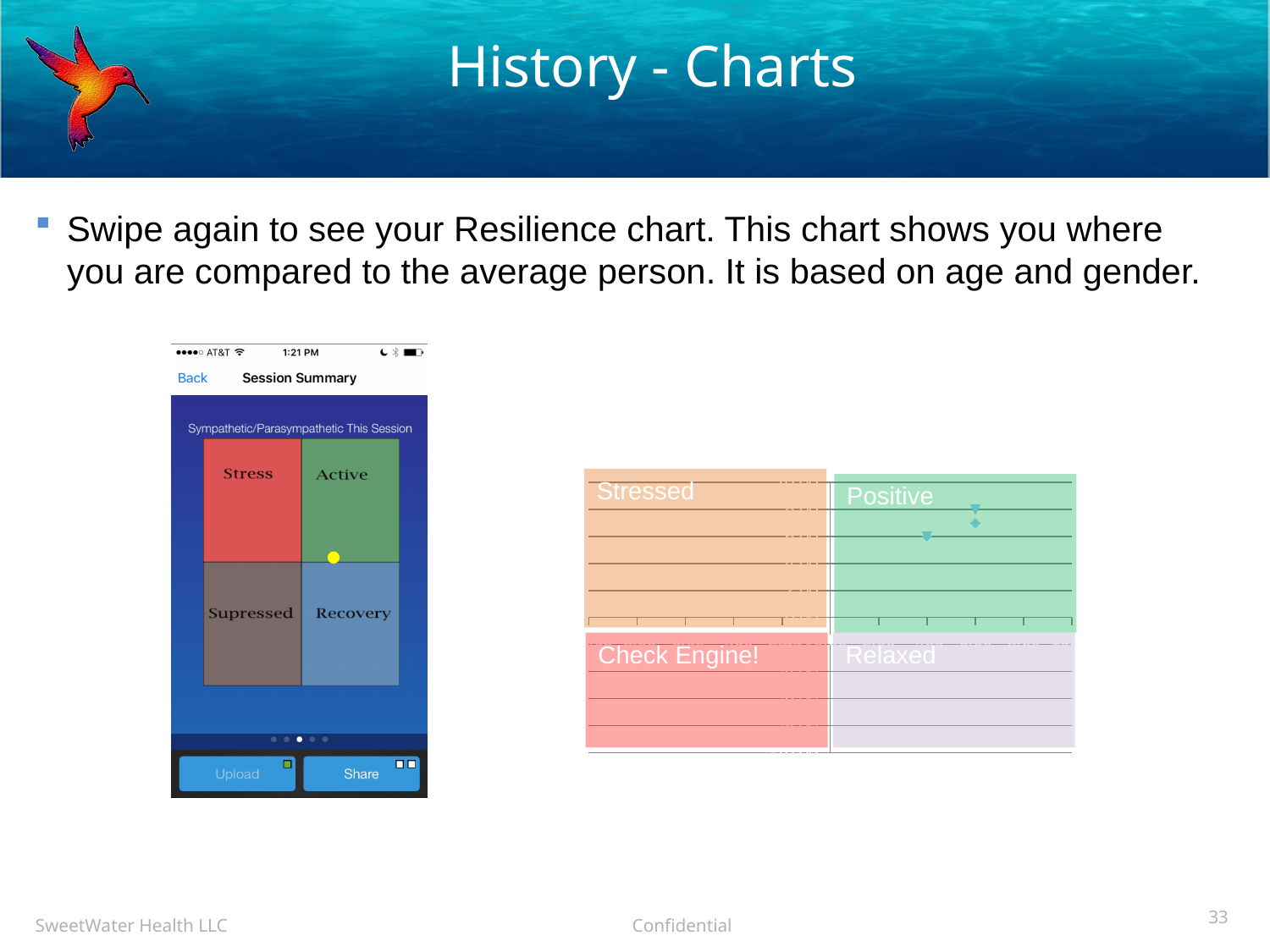
On the right-hand chart, how many quadrants are shown? 4 What kind of chart is the right-hand chart? scatter chart On the phone screenshot chart, what is the chart title shown above the quadrants? Sympathetic/Parasympathetic This Session On the right-hand chart, what is the label of the top-left quadrant? Stressed On the right-hand chart, in which quadrant are the plotted markers located? Positive On the phone screenshot chart, how many quadrants are shown? 4